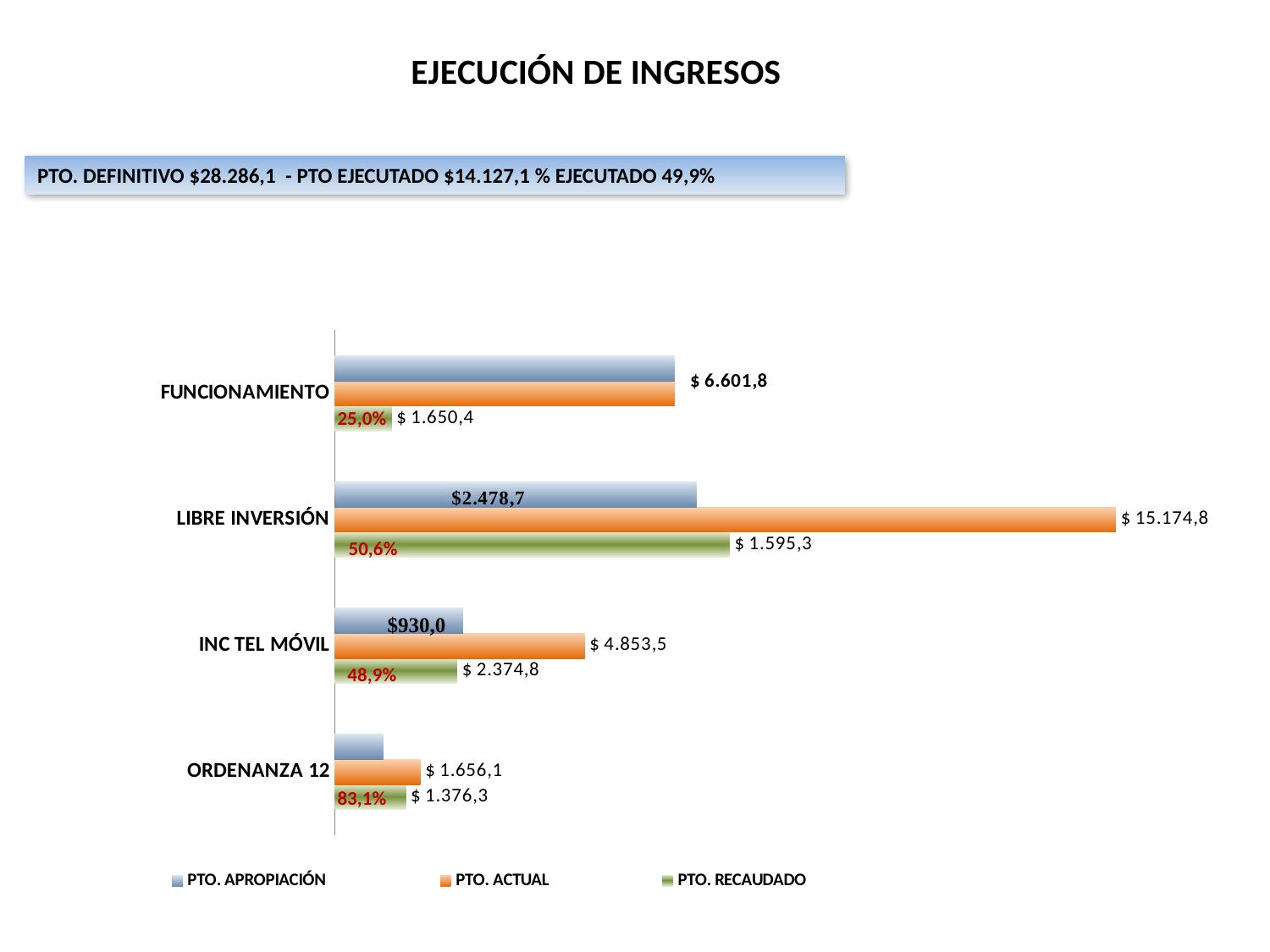
How many series does the legend list? 3 What is the title of the chart? EJECUCIÓN DE INGRESOS How many categories are shown on the chart? 4 What percentage is printed on the PTO. RECAUDADO bar for ORDENANZA 12? 83,1% What is the PTO. ACTUAL value for LIBRE INVERSIÓN? $ 15.174,8 What is the difference between the PTO. ACTUAL values for INC TEL MÓVIL and ORDENANZA 12? $ 3.197,4 What is the PTO. RECAUDADO value for ORDENANZA 12? $ 1.376,3 Which is larger, the PTO. ACTUAL value for LIBRE INVERSIÓN or for INC TEL MÓVIL? LIBRE INVERSIÓN What is the PTO. ACTUAL value for INC TEL MÓVIL? $ 4.853,5 What kind of chart is shown on the slide? bar chart Which category has the highest PTO. ACTUAL value? LIBRE INVERSIÓN Which category has the lowest PTO. ACTUAL value? ORDENANZA 12